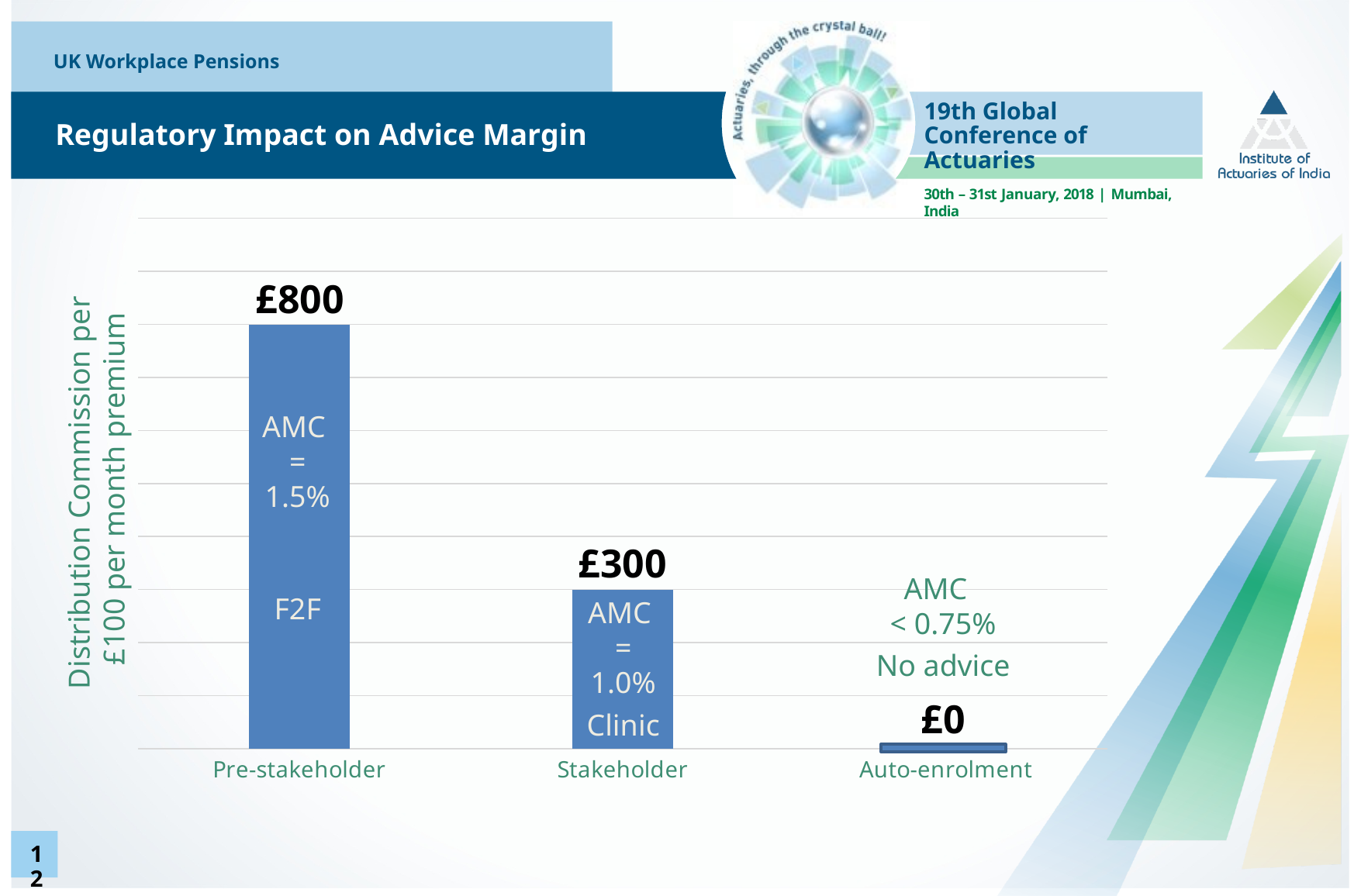
Which is larger, the value for Stakeholder or the value for Auto-enrolment? Stakeholder What is the Distribution Commission value for Auto-enrolment? £0 What is the difference between the Pre-stakeholder and Stakeholder values? £500 What is the y-axis label of the chart? Distribution Commission per £100 per month premium What kind of chart is shown on the slide? Bar chart What is the Distribution Commission value for Stakeholder? £300 Which category has the highest Distribution Commission? Pre-stakeholder What is the Distribution Commission value for Pre-stakeholder? £800 How many categories are shown on the x axis? 3 What AMC is shown inside the Stakeholder bar? 1.0% Do the values rise or fall moving from Pre-stakeholder to Auto-enrolment along the x axis? Fall Which category has the lowest Distribution Commission? Auto-enrolment